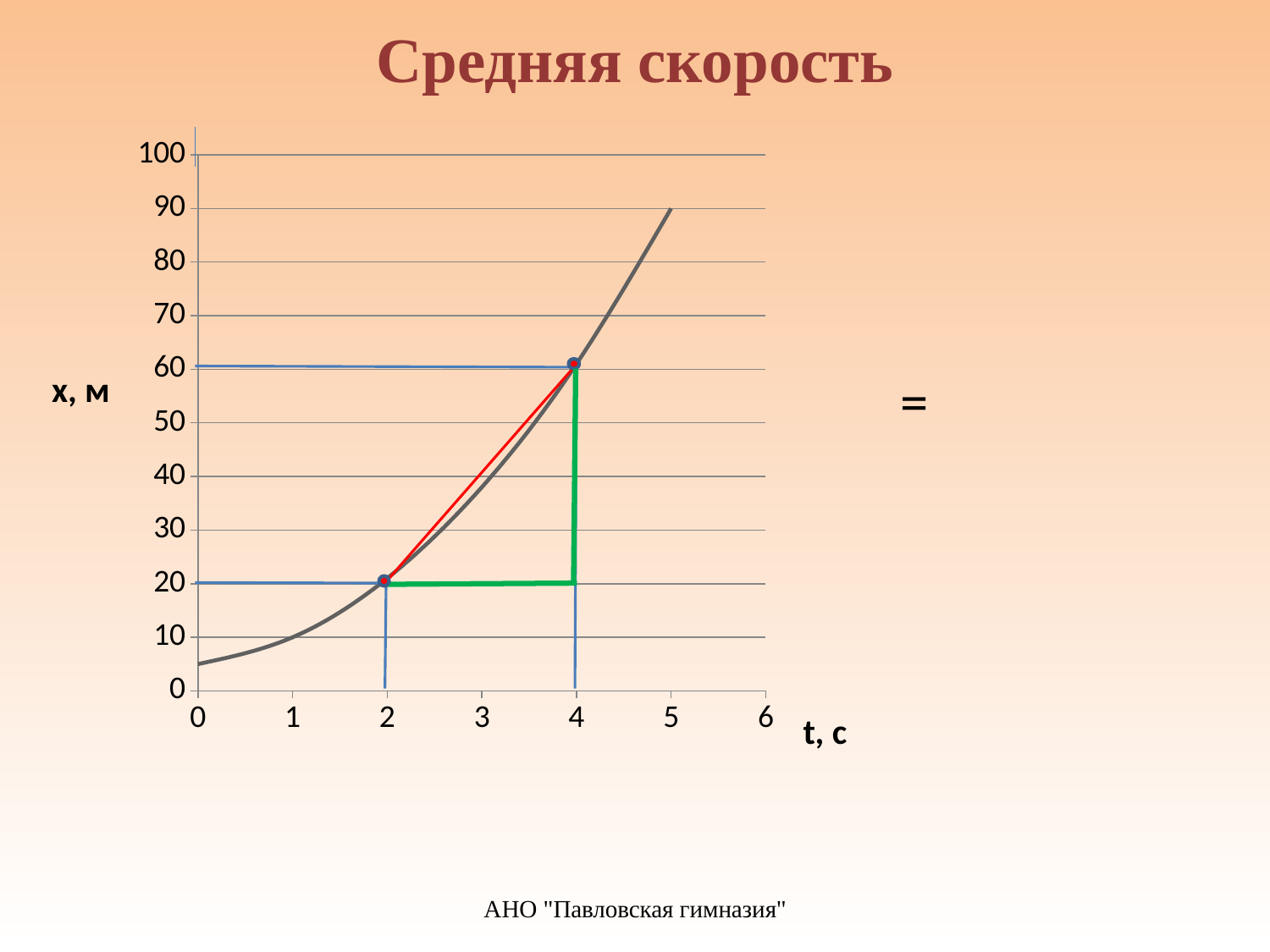
Is the value of x at t = 0 greater or less than 10? less Is the value of x at t = 4.5 greater or less than 70? greater What is the title of the slide? Средняя скорость What kind of chart is shown on the slide? line chart Does the curve rise or fall as t increases? rises Which is larger: the x value at t = 4 or at t = 2? t = 4 What is the label of the vertical axis? x, м How many points are marked with dots on the curve? 2 What is the highest tick value shown on the vertical axis? 100